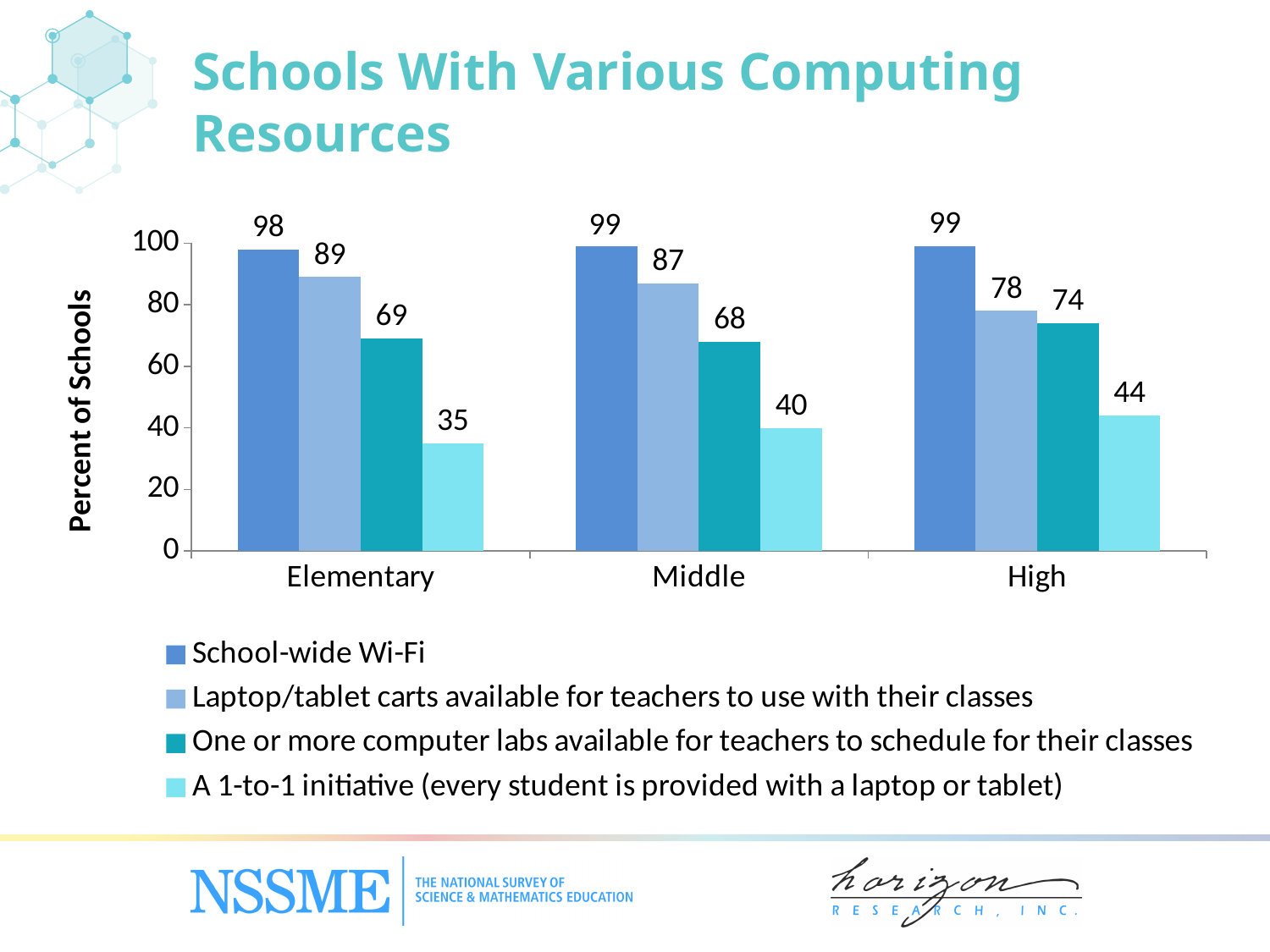
What kind of chart is shown on the slide? Bar chart Is the value for a 1-to-1 initiative at high schools greater or less than 60? less What is the label of the y axis? Percent of Schools What percent of high schools have laptop/tablet carts available for teachers to use with their classes? 78 What is the value for a 1-to-1 initiative at middle schools? 40 How many school levels are shown on the x axis? 3 Which resource has the highest value at high schools? School-wide Wi-Fi Which is larger: the computer labs value for middle schools or for high schools? High How many series does the legend list? 4 What percent of elementary schools have school-wide Wi-Fi? 98 Which school level has the lowest value for a 1-to-1 initiative? Elementary What is the difference between the laptop/tablet carts value for elementary schools and for high schools? 11